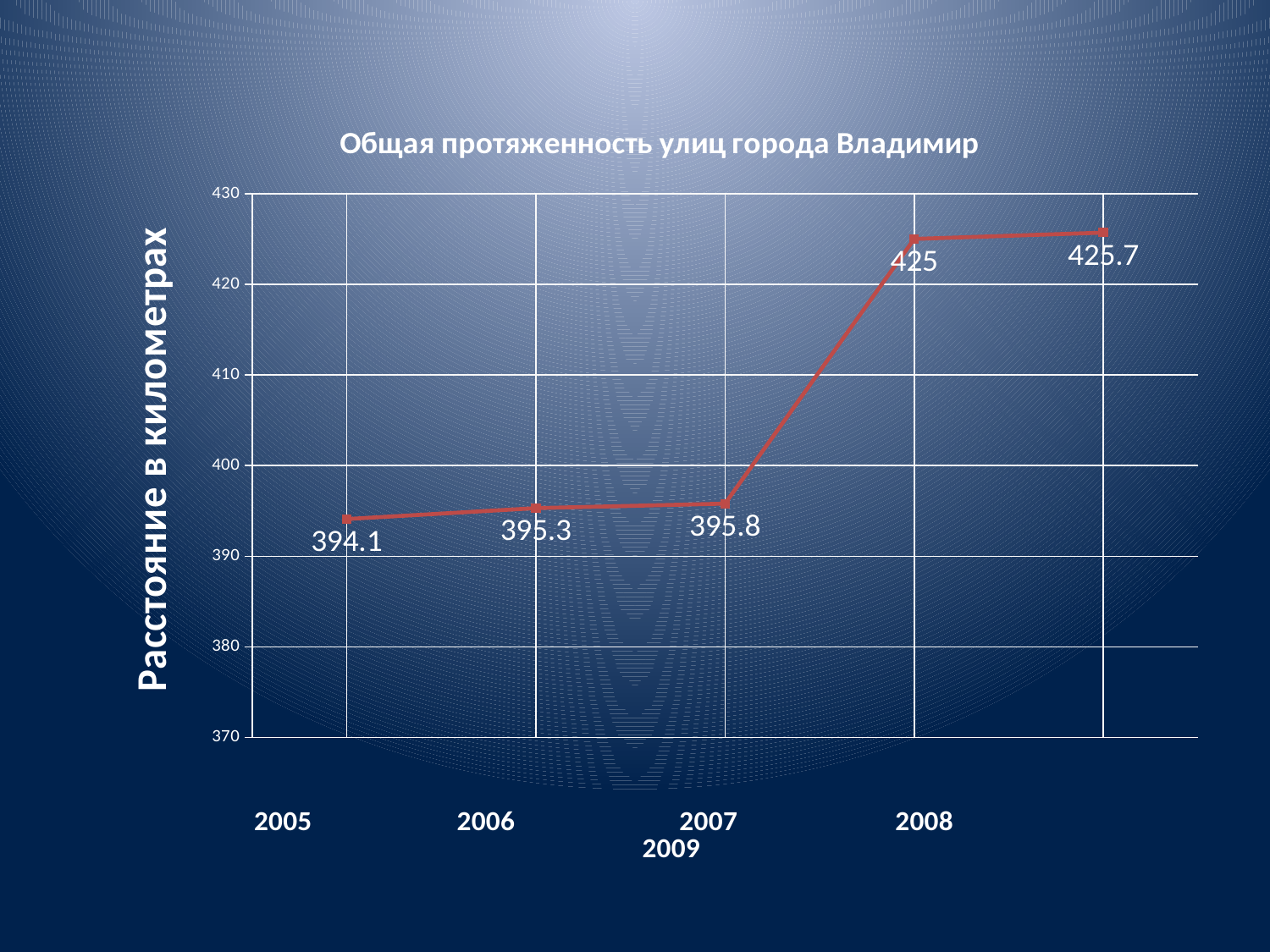
Which year has the highest value? 2009 How many data points are plotted on the chart? 5 What kind of chart is shown on the slide? line chart What is the title of the chart? Общая протяженность улиц города Владимир Do the values rise or fall from 2005 to 2009? rise Which is larger, the value for 2006 or the value for 2008? 2008 What is the difference between the values for 2008 and 2007? 29.2 Is the value for 2008 greater or less than 420? greater Which year has the lowest value? 2005 What is the value for 2007? 395.8 What is the value for 2005? 394.1 What is the value for 2009? 425.7